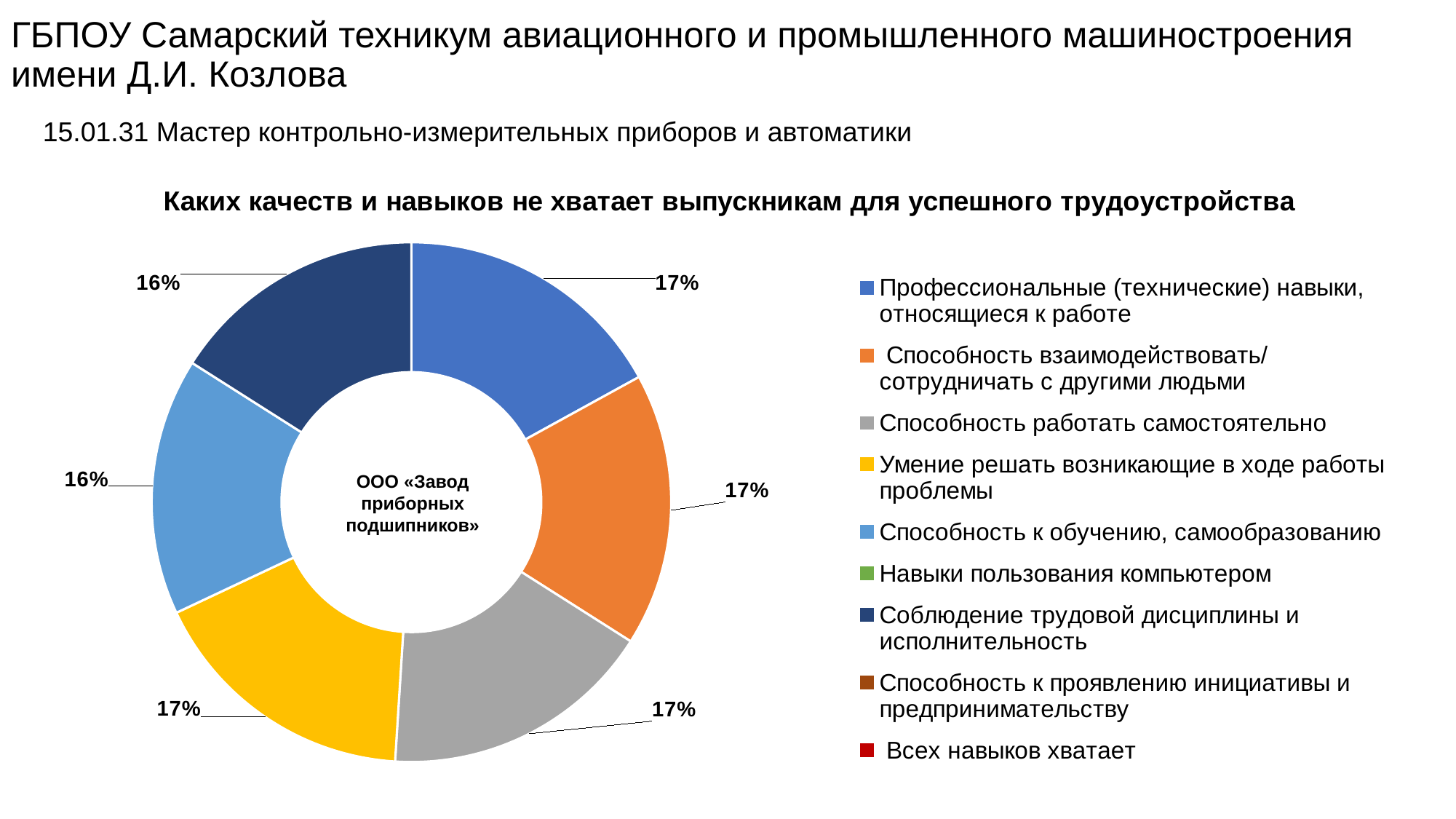
What is the difference between the share for 'Профессиональные (технические) навыки, относящиеся к работе' and the share for 'Соблюдение трудовой дисциплины и исполнительность'? 1% What kind of chart is shown on the slide? doughnut chart What percentage is shown for the slice 'Умение решать возникающие в ходе работы проблемы'? 17% What percentage is shown for the slice 'Соблюдение трудовой дисциплины и исполнительность'? 16% What share of the chart does 'Способность работать самостоятельно' take? 17% What is the title of the chart? Каких качеств и навыков не хватает выпускникам для успешного трудоустройства How many entries does the legend list? 9 Which slice is larger: 'Способность взаимодействовать/сотрудничать с другими людьми' or 'Способность к обучению, самообразованию'? Способность взаимодействовать/сотрудничать с другими людьми How many slices with percentage labels are visible in the chart? 6 What percentage is shown for the slice 'Способность к обучению, самообразованию'? 16% What percentage is shown for the slice 'Профессиональные (технические) навыки, относящиеся к работе'? 17% What text is written in the centre of the doughnut chart? ООО «Завод приборных подшипников»